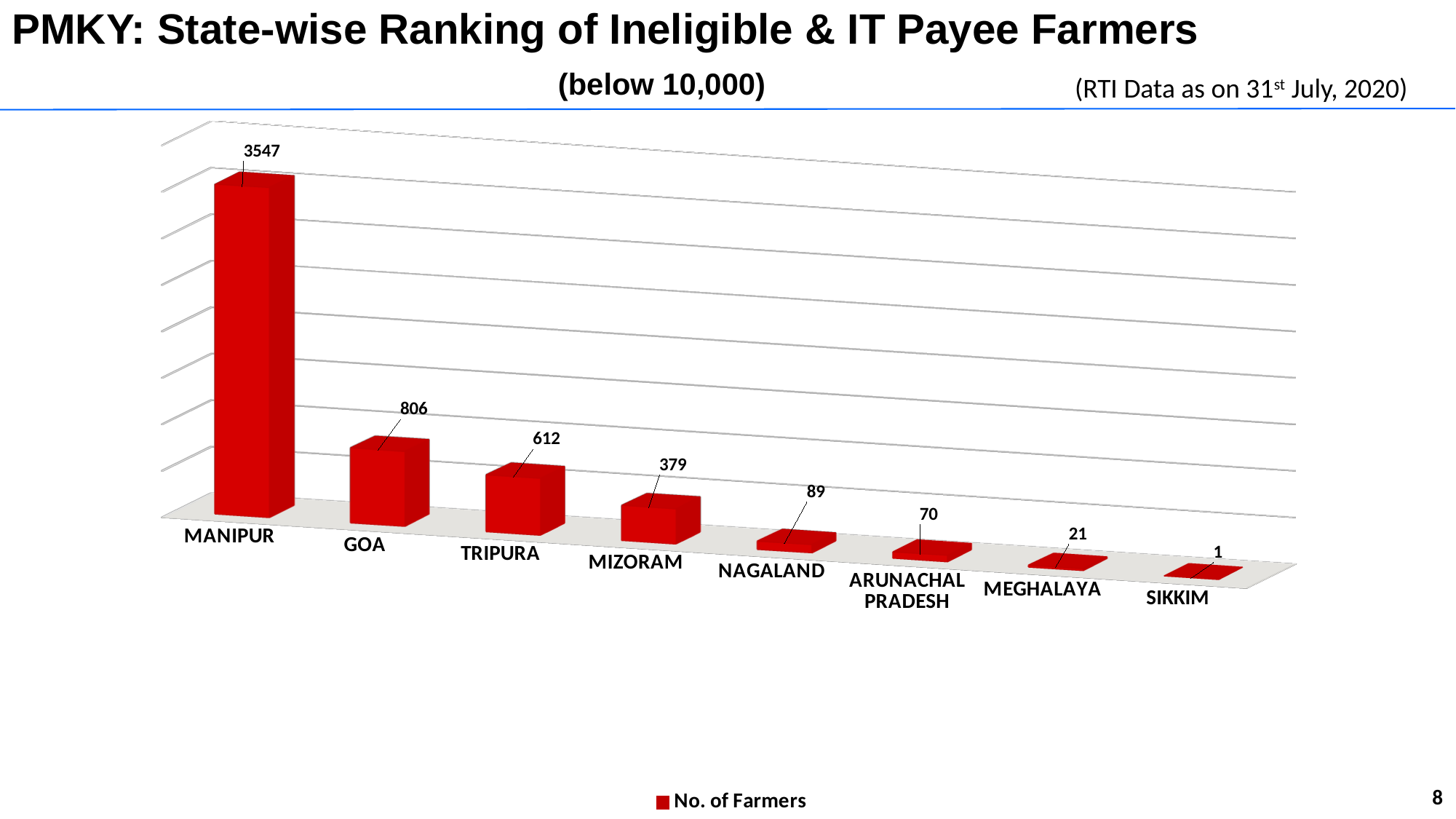
Which state has the highest number of farmers? Manipur What is the number of farmers for Manipur? 3547 Which has more farmers, Tripura or Mizoram? Tripura What kind of chart is shown on the slide? Bar chart What is the difference between the number of farmers for Nagaland and Meghalaya? 68 What is the number of farmers for Mizoram? 379 What is the number of farmers for Arunachal Pradesh? 70 How many states are shown in the chart? 8 What series name does the legend show? No. of Farmers What is the difference between the number of farmers for Goa and Tripura? 194 What is the number of farmers for Goa? 806 Which state has the lowest number of farmers? Sikkim